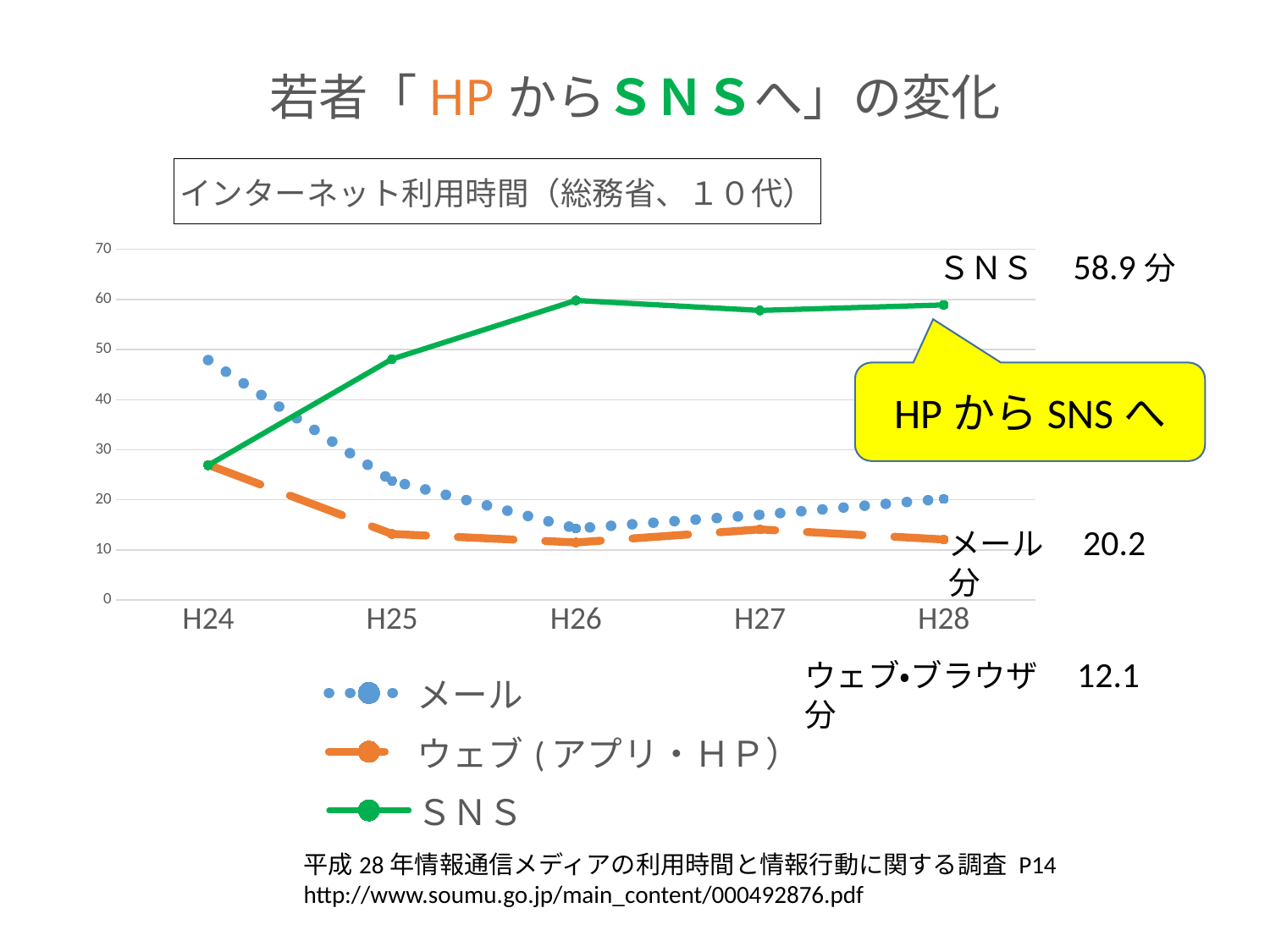
What is the value for SNS at H28? 58.9分 What is the difference between the SNS value and the メール value at H28? 38.7分 Which series has the lowest value at H28? ウェブ (アプリ・HP) How many series does the legend list? 3 What kind of chart is shown on the slide? line chart What is the value for ウェブ (アプリ・HP) at H28? 12.1分 How many time points are shown on the x axis? 5 Is the value for メール at H24 greater or less than 40? greater What is the value for メール at H28? 20.2分 Which series is drawn with a dotted blue line? メール Which series has the highest value at H28? SNS Does the SNS series rise or fall from H24 to H28? rise